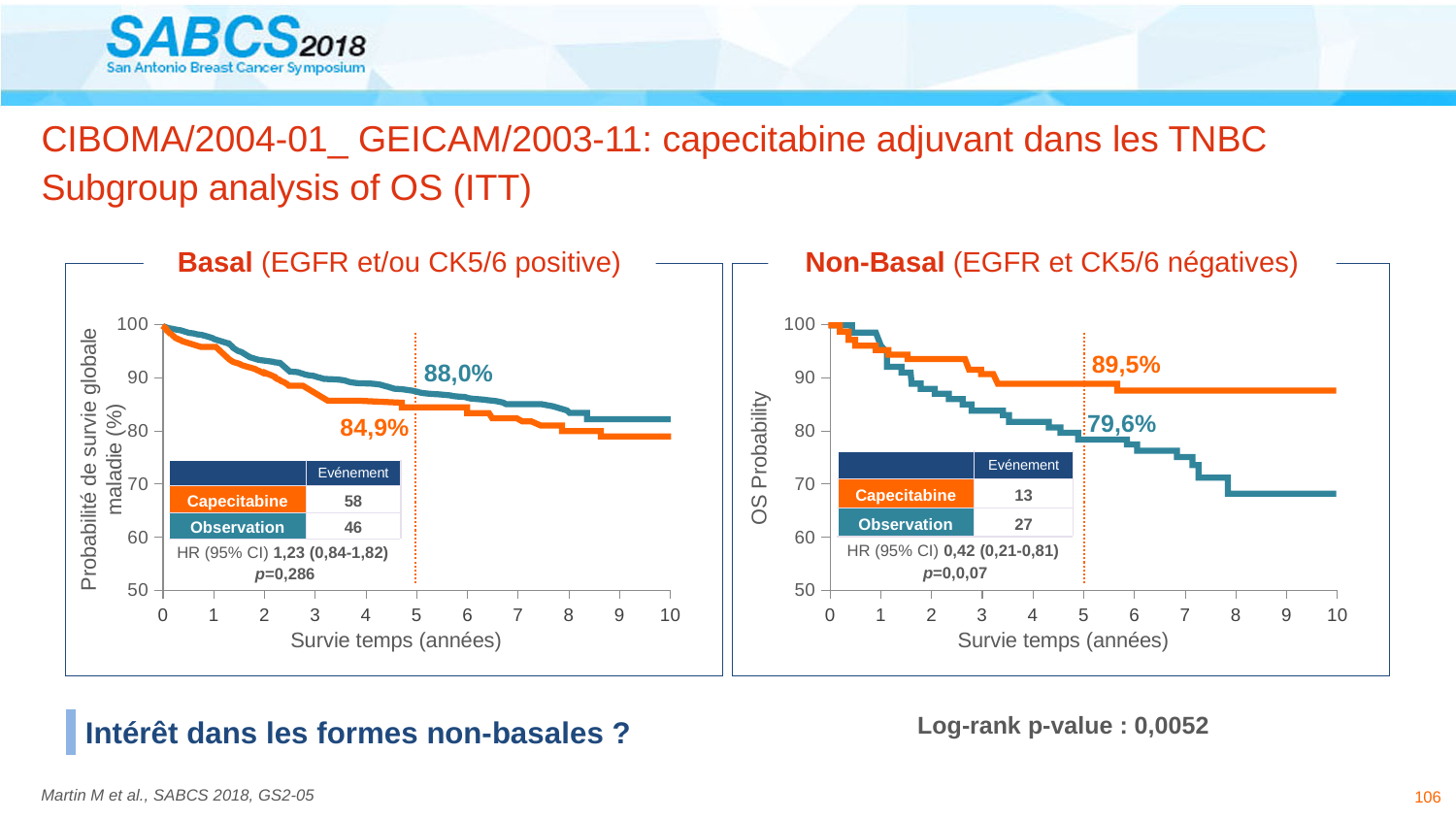
On the Non-Basal chart, what is the 5-year OS value labelled for the Observation curve? 79,6% On the Non-Basal chart, is the Capecitabine curve at 10 years greater or less than 80? greater On the Non-Basal chart, what is the difference between the labelled 5-year OS values for Capecitabine and Observation? 9,9 percentage points On the Basal chart, what is the difference between the labelled 5-year OS values for Observation and Capecitabine? 3,1 percentage points On the Non-Basal chart, how many events are reported for the Observation arm? 27 On the Basal chart, how many events are reported for the Capecitabine arm? 58 On the Basal chart, which arm has the higher labelled 5-year OS value, Capecitabine or Observation? Observation What kind of chart is shown in each panel? Line chart (Kaplan-Meier survival curve) On the Basal chart, what is the 5-year overall survival value labelled for the Capecitabine (orange) curve? 84,9% On the Basal chart, what is the 5-year overall survival value labelled for the Observation (teal) curve? 88,0% On the Non-Basal chart, what is the 5-year OS value labelled for the Capecitabine curve? 89,5% On the Non-Basal chart, what is the hazard ratio (95% CI) shown? 0,42 (0,21-0,81)